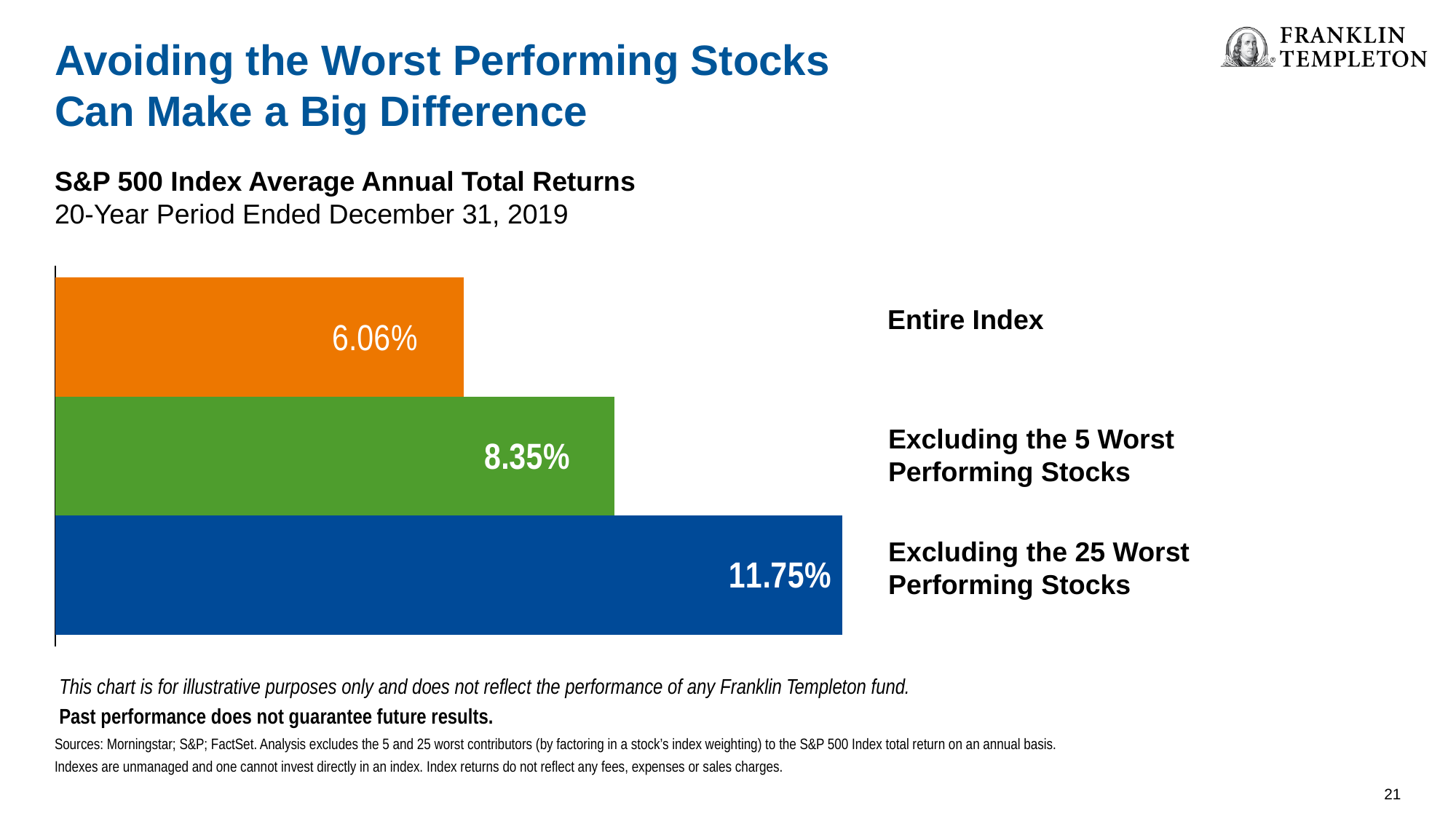
What is the average annual total return shown for Excluding the 25 Worst Performing Stocks? 11.75% What colour is the bar for the Entire Index? Orange What kind of chart is shown on the slide? Bar chart Which is larger, the return for the Entire Index or the return for Excluding the 5 Worst Performing Stocks? Excluding the 5 Worst Performing Stocks What is the average annual total return shown for the Entire Index? 6.06% How many bars are shown in the chart? 3 Which category has the lowest average annual total return? Entire Index What is the average annual total return shown for Excluding the 5 Worst Performing Stocks? 8.35% What is the difference in percentage points between Excluding the 25 Worst Performing Stocks and the Entire Index? 5.69 Which category has the highest average annual total return? Excluding the 25 Worst Performing Stocks What is the difference in percentage points between Excluding the 25 Worst Performing Stocks and Excluding the 5 Worst Performing Stocks? 3.40 What is the difference in percentage points between Excluding the 5 Worst Performing Stocks and the Entire Index? 2.29